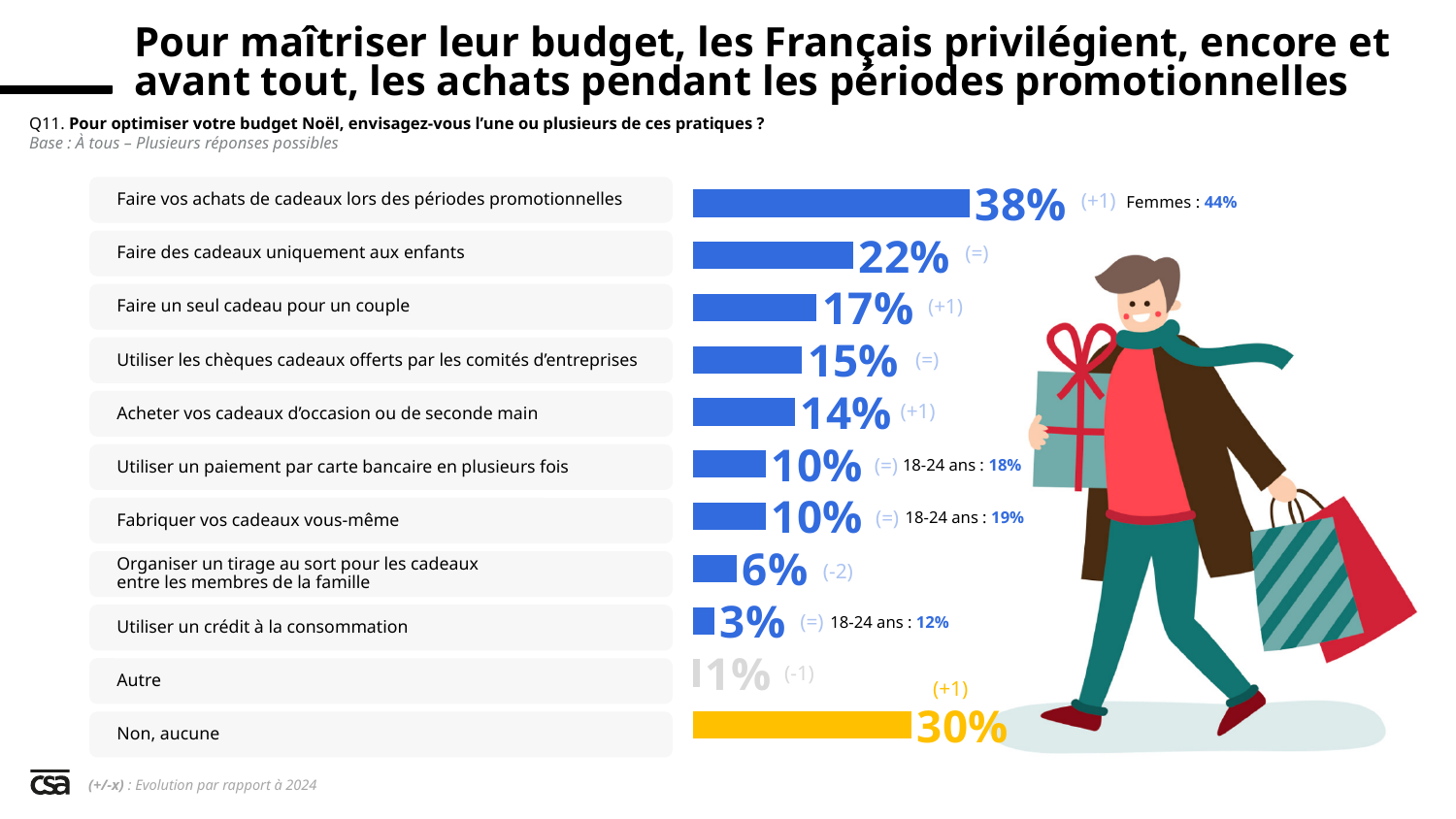
Which category has the lowest percentage on the chart? Autre Which practice has the highest percentage on the chart? Faire vos achats de cadeaux lors des périodes promotionnelles What kind of chart is shown on the slide? Bar chart Which is larger: the value for "Faire un seul cadeau pour un couple" or the value for "Utiliser les chèques cadeaux offerts par les comités d'entreprises"? Faire un seul cadeau pour un couple What is the evolution compared to 2024 shown next to the "Non, aucune" bar? +1 What percentage of respondents plan to buy gifts during promotional periods ("Faire vos achats de cadeaux lors des périodes promotionnelles")? 38% What percentage is shown for "Utiliser un crédit à la consommation"? 3% How many categories (practices) are listed on the chart? 11 What is the value for "Acheter vos cadeaux d'occasion ou de seconde main"? 14% What percentage of women ("Femmes") is indicated next to the bar for buying gifts during promotional periods? 44% What is the value shown for "Non, aucune"? 30% What is the difference in percentage points between "Faire vos achats de cadeaux lors des périodes promotionnelles" and "Faire des cadeaux uniquement aux enfants"? 16 points